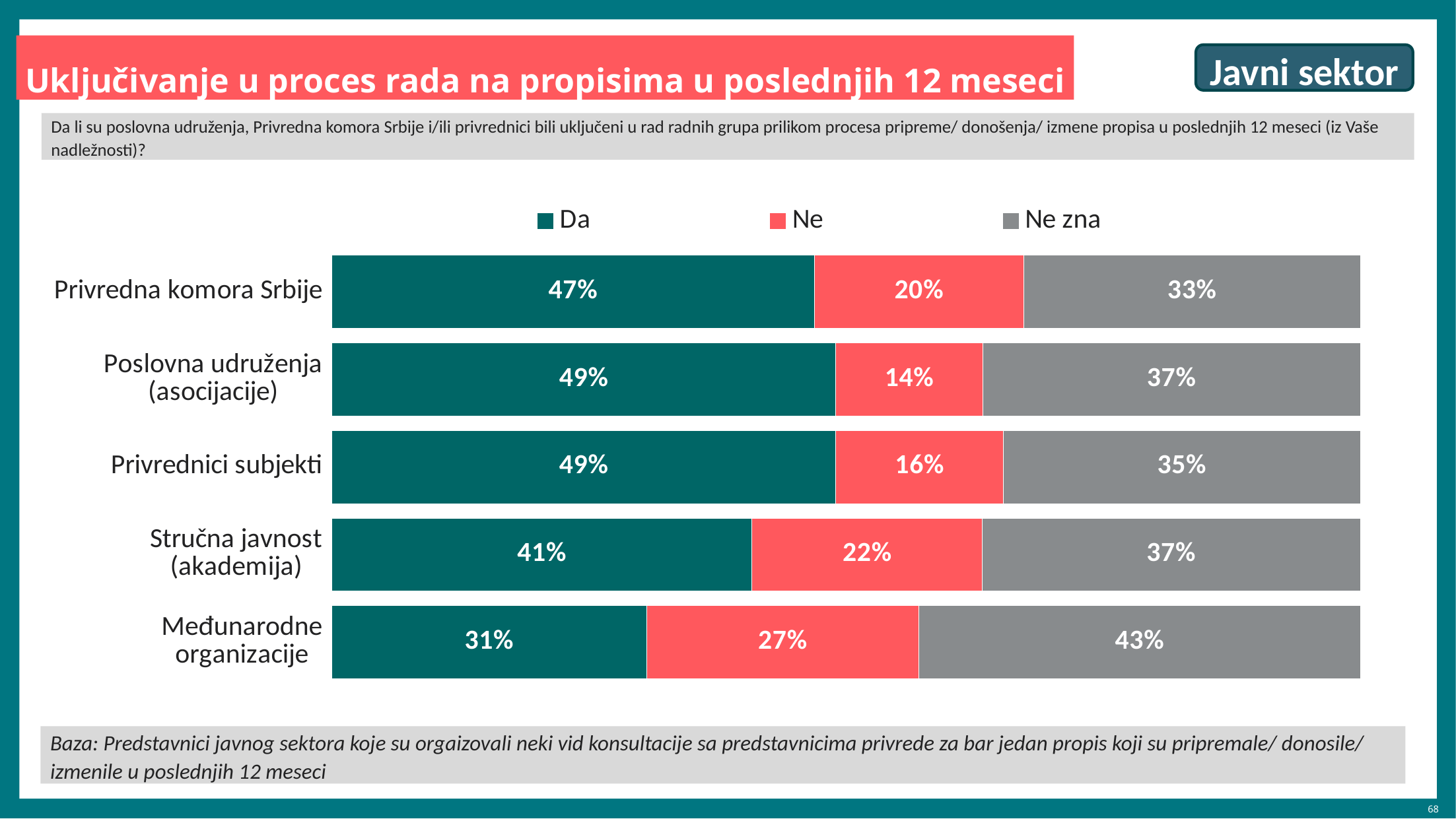
What is the difference between the "Da" values for Privredna komora Srbije and Međunarodne organizacije? 16% Which category has the lowest "Da" value? Međunarodne organizacije How many series does the legend list? 3 Is the "Ne zna" value larger for Privrednici subjekti or for Stručna javnost (akademija)? Stručna javnost (akademija) Which category has the lowest "Ne" value? Poslovna udruženja (asocijacije) Which category has the highest "Ne" value? Međunarodne organizacije What is the "Ne zna" value for Međunarodne organizacije? 43% Which series is shown in red in the chart? Ne How many categories are shown in the chart? 5 What kind of chart is shown on the slide? Stacked bar chart What is the "Da" value for Privredna komora Srbije? 47% What is the "Ne" value for Stručna javnost (akademija)? 22%